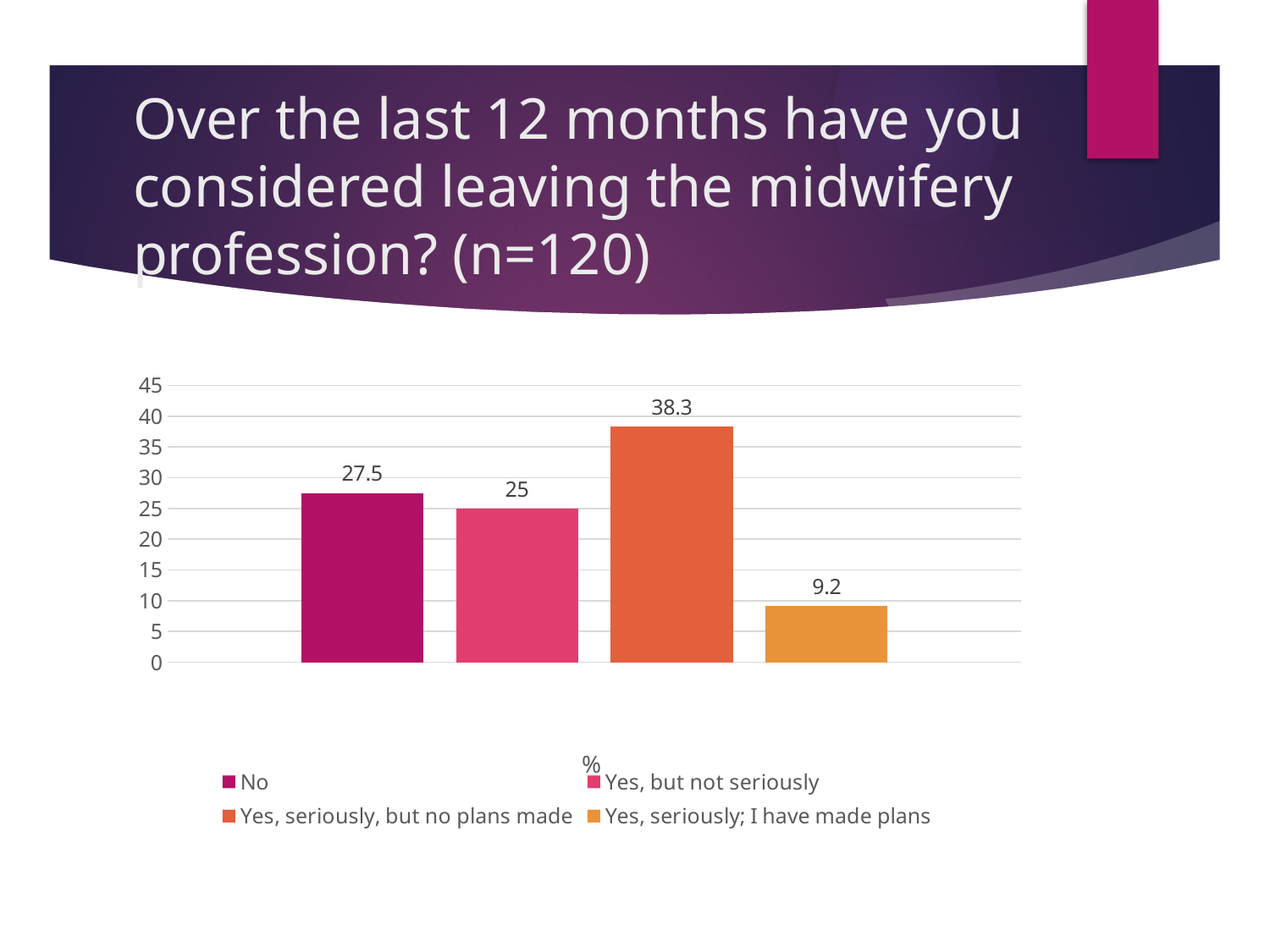
What colour is the bar for "Yes, seriously; I have made plans"? orange Is the value for "Yes, seriously; I have made plans" greater or less than 10? less Which is larger, the value for "No" or the value for "Yes, but not seriously"? No What is the value for "Yes, but not seriously"? 25 How many categories are shown in the chart? 4 Which category has the highest value? Yes, seriously, but no plans made What is the difference between the values for "Yes, seriously, but no plans made" and "No"? 10.8 Which category has the lowest value? Yes, seriously; I have made plans What is the value for "Yes, seriously; I have made plans"? 9.2 What is the value for "No"? 27.5 What kind of chart is shown on the slide? bar chart What is the value for "Yes, seriously, but no plans made"? 38.3